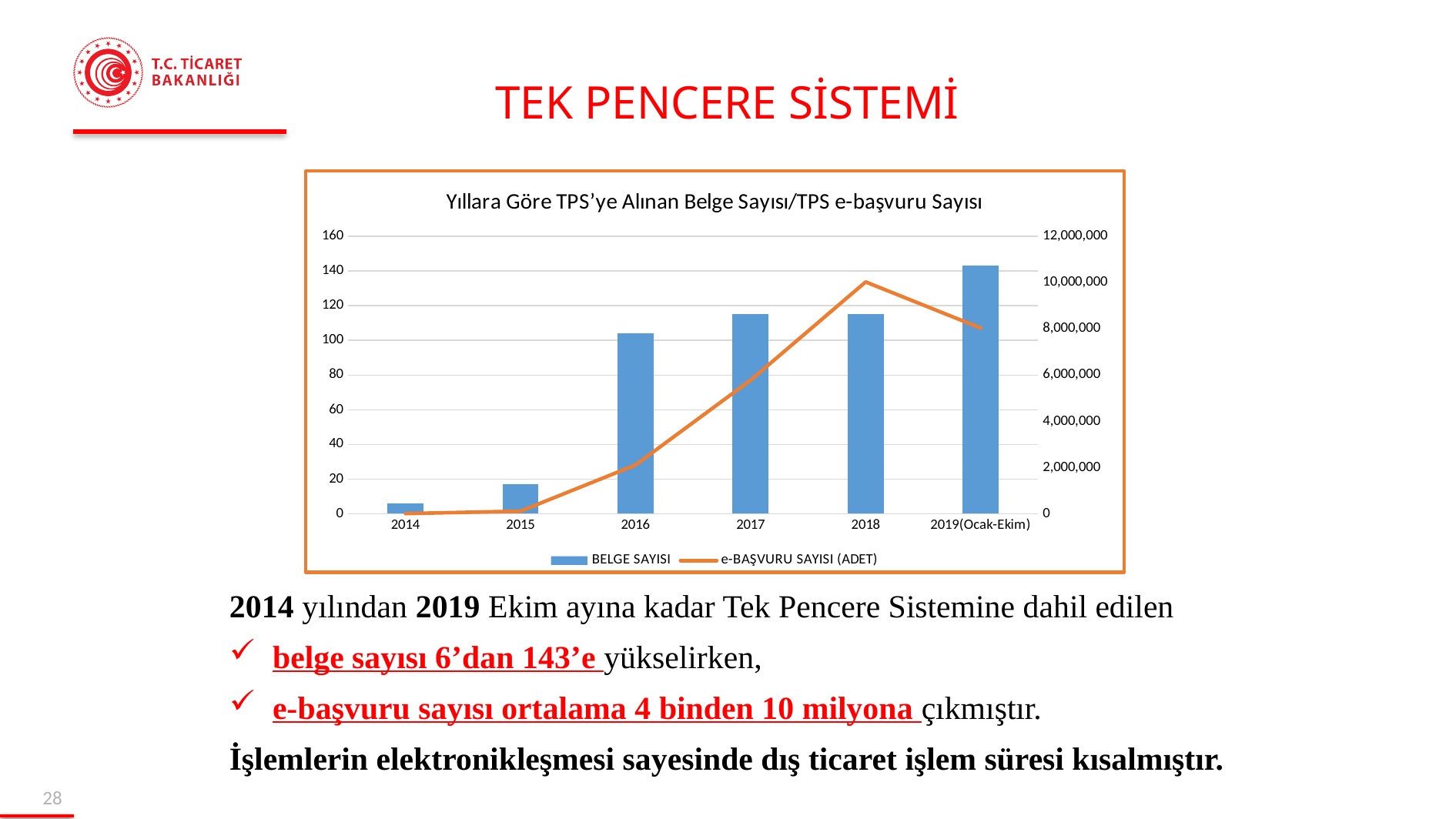
Which year has the lowest BELGE SAYISI bar? 2014 How many series does the legend list? 2 Is the e-BAŞVURU SAYISI (ADET) value for 2018 greater or less than 8,000,000? greater Is the BELGE SAYISI value for 2015 greater or less than 40? less What kind of chart is shown on the slide? A combination bar and line chart Does the e-BAŞVURU SAYISI (ADET) line rise or fall from 2014 to 2018? Rise Which year has the highest BELGE SAYISI bar? 2019(Ocak-Ekim) Is the BELGE SAYISI value for 2017 greater or less than 100? greater What is the title of the chart? Yıllara Göre TPS'ye Alınan Belge Sayısı/TPS e-başvuru Sayısı In which year does the e-BAŞVURU SAYISI (ADET) line reach its peak? 2018 How many year categories are shown on the x axis? 6 Which is larger, the BELGE SAYISI bar for 2018 or for 2019(Ocak-Ekim)? 2019(Ocak-Ekim)